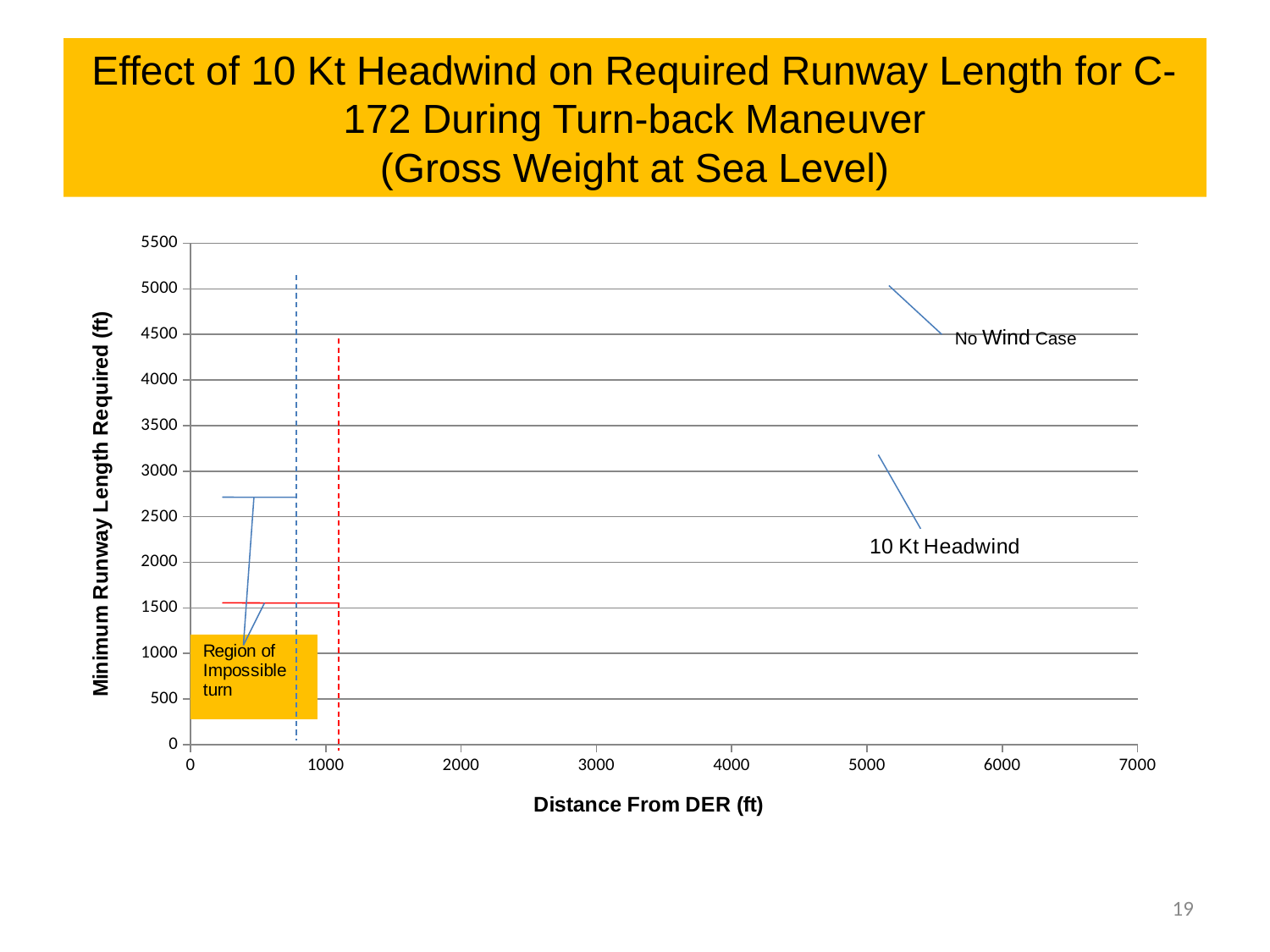
What is the title of the chart's x axis? Distance From DER (ft) What is the highest value shown on the y axis? 5500 What is the highest value shown on the x axis? 7000 Which of the two plotted cases requires the longer minimum runway length, the No Wind Case or the 10 Kt Headwind case? No Wind Case What kind of chart is shown on the slide? line chart How many plotted cases are labelled on the chart? 2